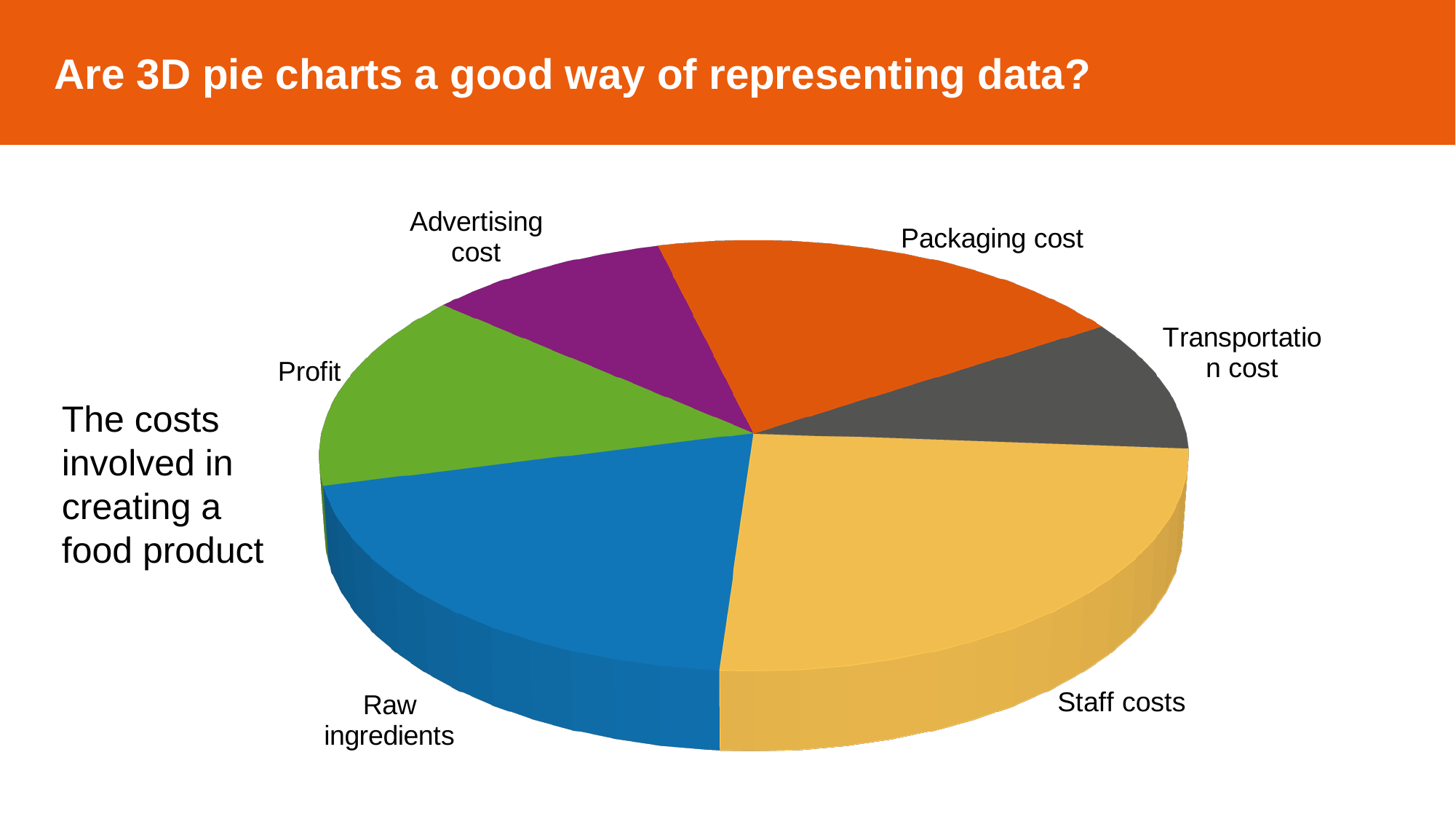
What is the pie chart described as showing, according to the text to its left? The costs involved in creating a food product Which slice is larger, Staff costs or Packaging cost? Staff costs What colour is the Staff costs slice of the pie chart? Yellow How many slices does the pie chart have? 6 Which slice is larger, Packaging cost or Transportation cost? Packaging cost Which slice is larger, Raw ingredients or Profit? Raw ingredients Which category has the largest slice of the pie chart? Staff costs What kind of chart is shown on the slide? Pie chart